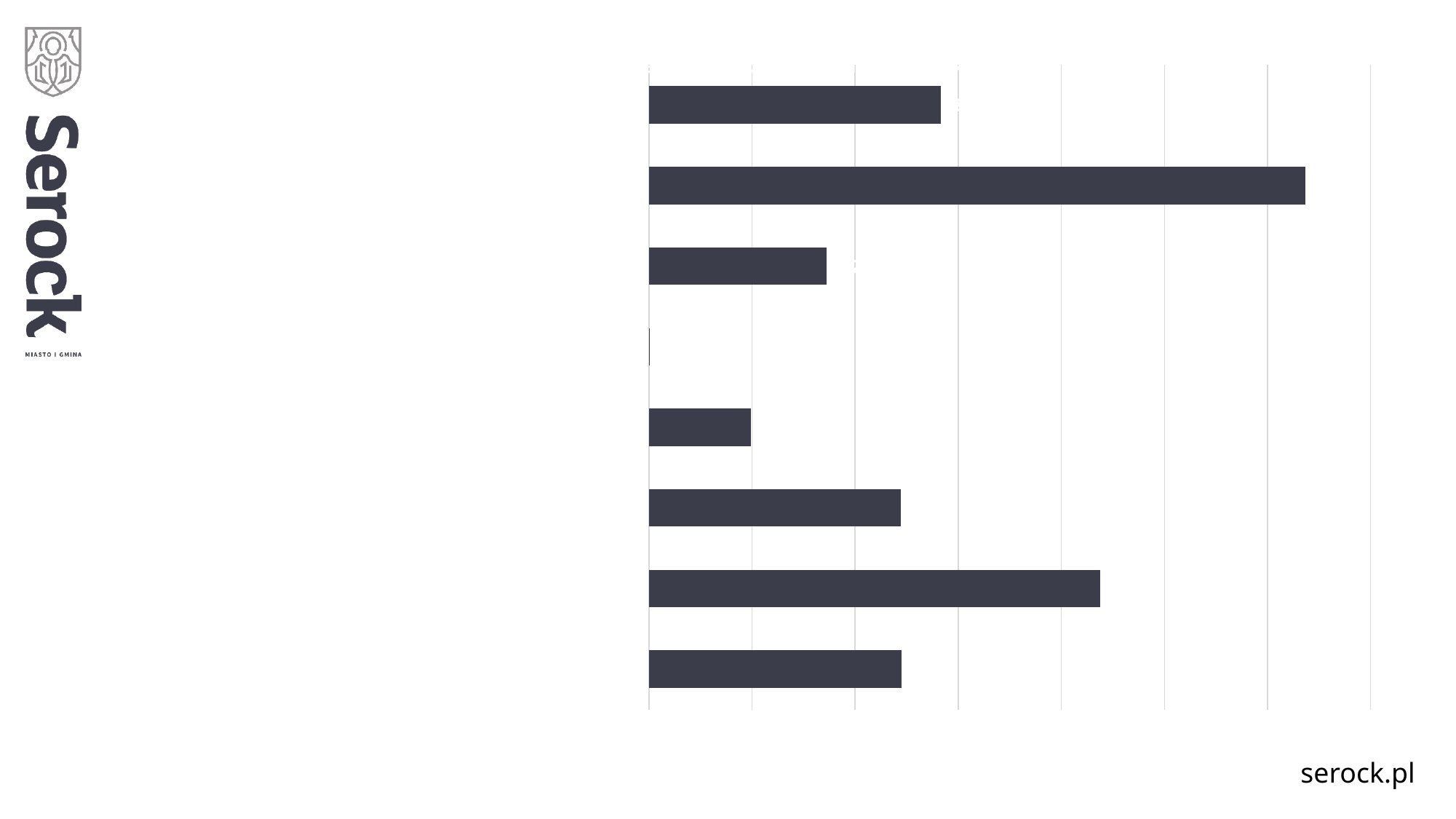
How many bars does the chart contain? 8 Which is longer, the fifth bar from the top or the seventh bar from the top? the seventh bar from the top Are the bars in the chart oriented horizontally or vertically? horizontally Which bar in the chart is the shortest? the fourth bar from the top Which bar in the chart is the longest? the second bar from the top What kind of chart is shown on the slide? bar chart Does the chart display a legend? No Which is longer, the first bar from the top or the third bar from the top? the first bar from the top